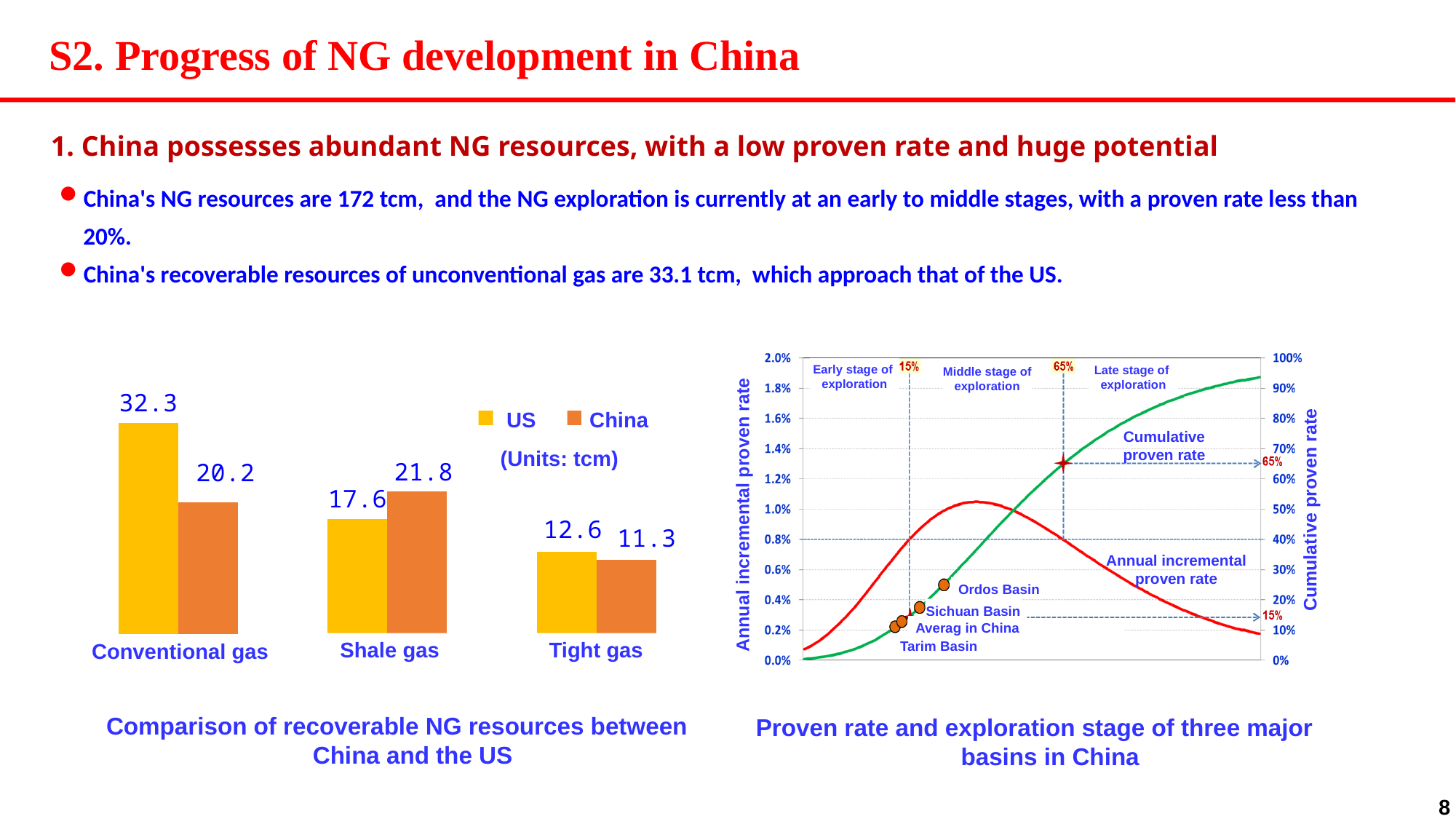
In the chart titled 'Comparison of recoverable NG resources between China and the US', how many categories are shown on the x axis? 3 In the chart titled 'Comparison of recoverable NG resources between China and the US', how many series does the legend list? 2 What kind of chart is the one titled 'Comparison of recoverable NG resources between China and the US'? Bar chart In the chart titled 'Comparison of recoverable NG resources between China and the US', which category has the lowest value for China? Tight gas In the chart titled 'Comparison of recoverable NG resources between China and the US', which is larger for Shale gas, the US or China? China In the chart titled 'Comparison of recoverable NG resources between China and the US', what is the value for the US for Conventional gas? 32.3 In the chart titled 'Comparison of recoverable NG resources between China and the US', what is the value for China for Shale gas? 21.8 In the chart titled 'Comparison of recoverable NG resources between China and the US', what is the value for China for Tight gas? 11.3 In the chart titled 'Comparison of recoverable NG resources between China and the US', which category has the highest value for the US? Conventional gas In the chart titled 'Proven rate and exploration stage of three major basins in China', what is the label of the right-hand vertical axis? Cumulative proven rate In the chart titled 'Comparison of recoverable NG resources between China and the US', what is the difference between the US and China values for Conventional gas? 12.1 In the chart titled 'Comparison of recoverable NG resources between China and the US', what units are the values given in? tcm